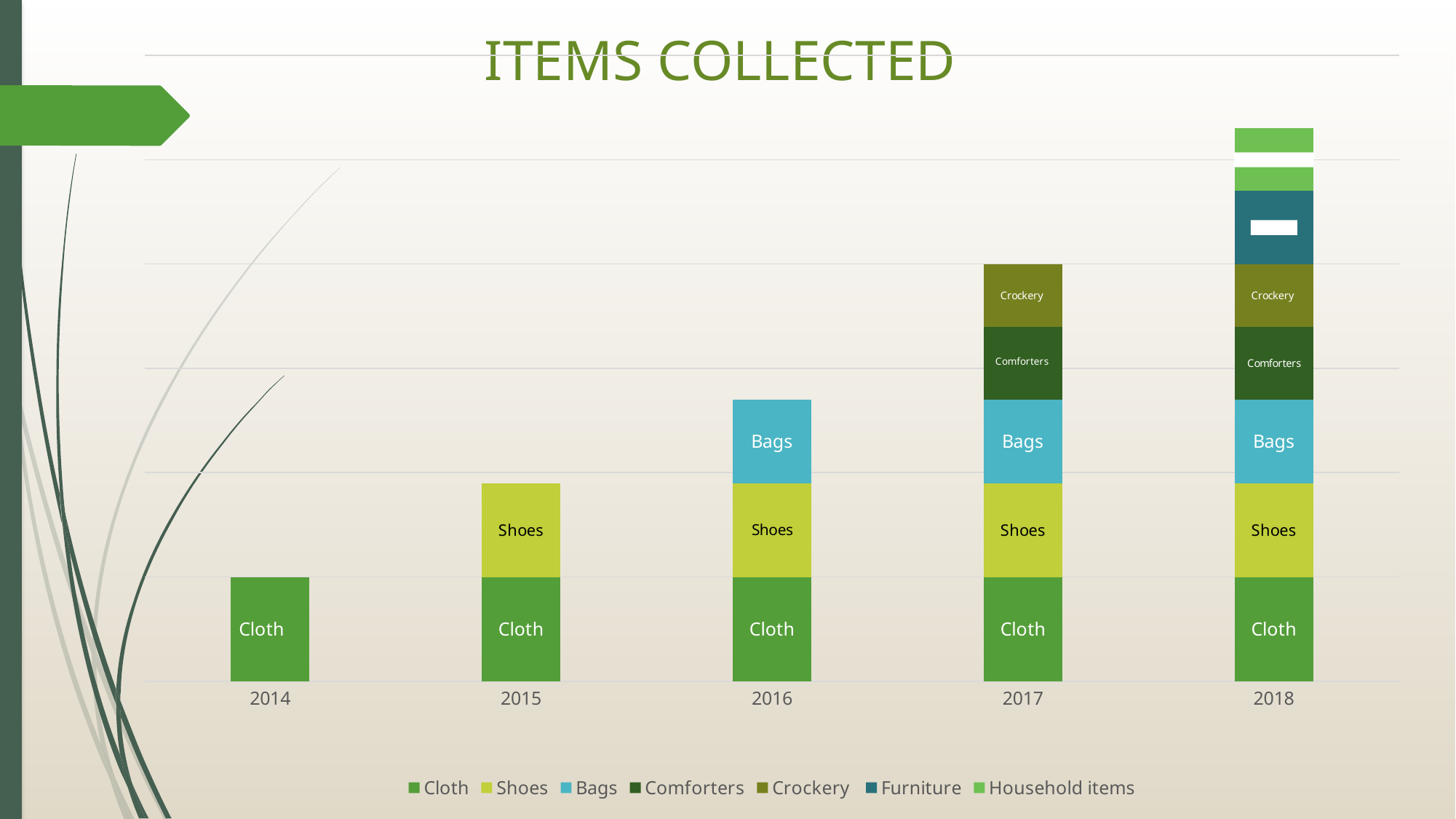
How many segments make up the bar for 2016? 3 How many series does the legend list? 7 Which item category is the only one collected in 2014? Cloth Do the total heights of the stacked bars rise or fall from 2014 to 2018? Rise What kind of chart is shown on the slide? Stacked bar chart Which year has the tallest stacked bar? 2018 How many years are shown on the x axis of the chart? 5 In which year do Bags first appear in the stacked bars? 2016 Which year has the shortest stacked bar? 2014 Which series is shown at the bottom of every stacked bar? Cloth What is the title of the chart? ITEMS COLLECTED Which bar is taller, 2015 or 2017? 2017